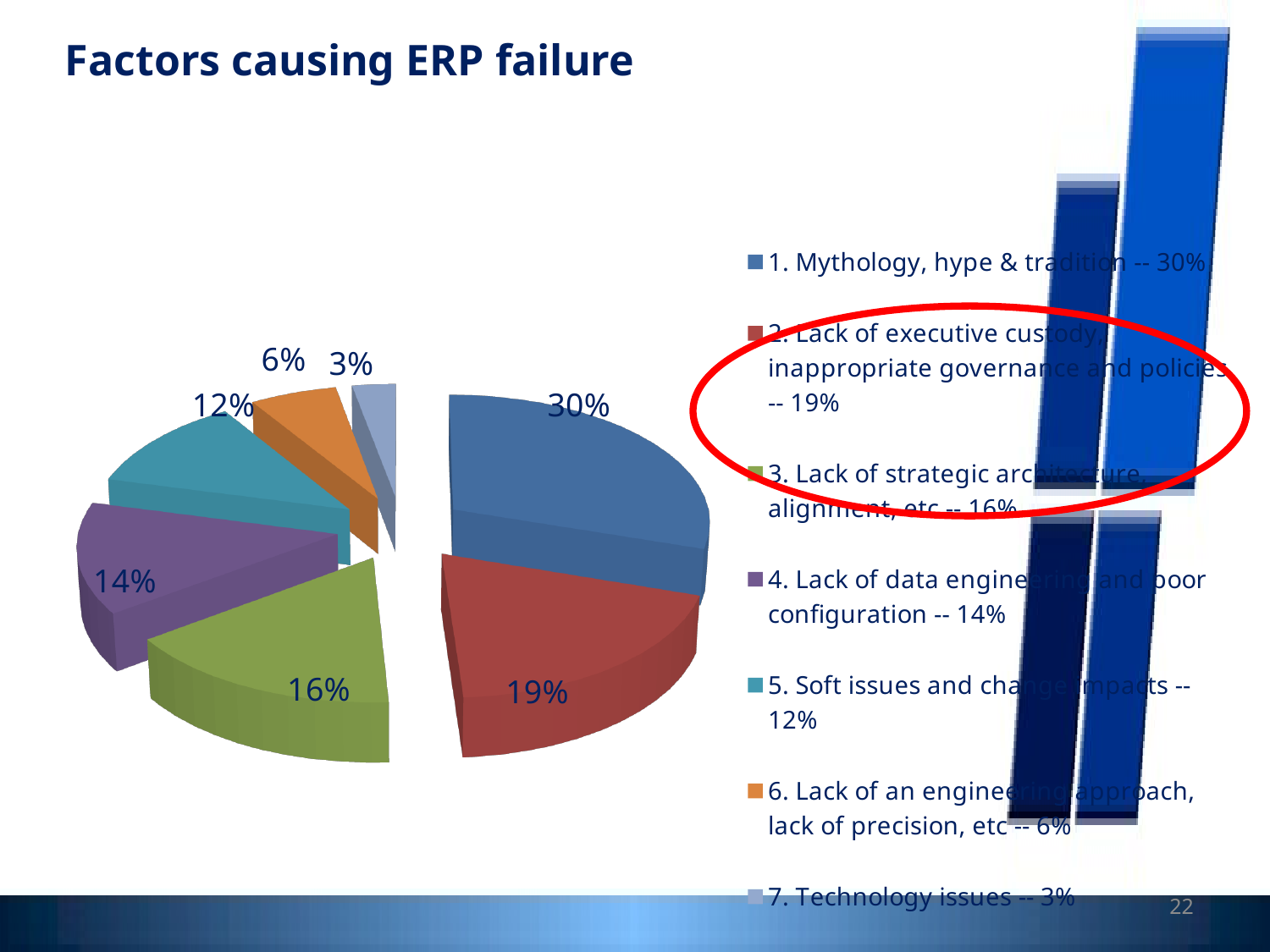
Which factor has the smallest slice of the pie? 7. Technology issues What is the title of the chart on the slide? Factors causing ERP failure What is the combined share of "3. Lack of strategic architecture, alignment, etc" and "4. Lack of data engineering and poor configuration"? 30% Which factor has the largest slice of the pie? 1. Mythology, hype & tradition What kind of chart is shown on the slide? Pie chart What percentage is shown for "7. Technology issues"? 3% How many entries does the legend list? 7 What percentage is shown for "4. Lack of data engineering and poor configuration"? 14% Which is larger: the slice for "5. Soft issues and change impacts" or the slice for "6. Lack of an engineering approach, lack of precision, etc"? 5. Soft issues and change impacts What share of the pie does "1. Mythology, hype & tradition" account for? 30% How many slices does the pie chart have? 7 What is the difference in percentage points between "1. Mythology, hype & tradition" and "2. Lack of executive custody, inappropriate governance and policies"? 11 percentage points